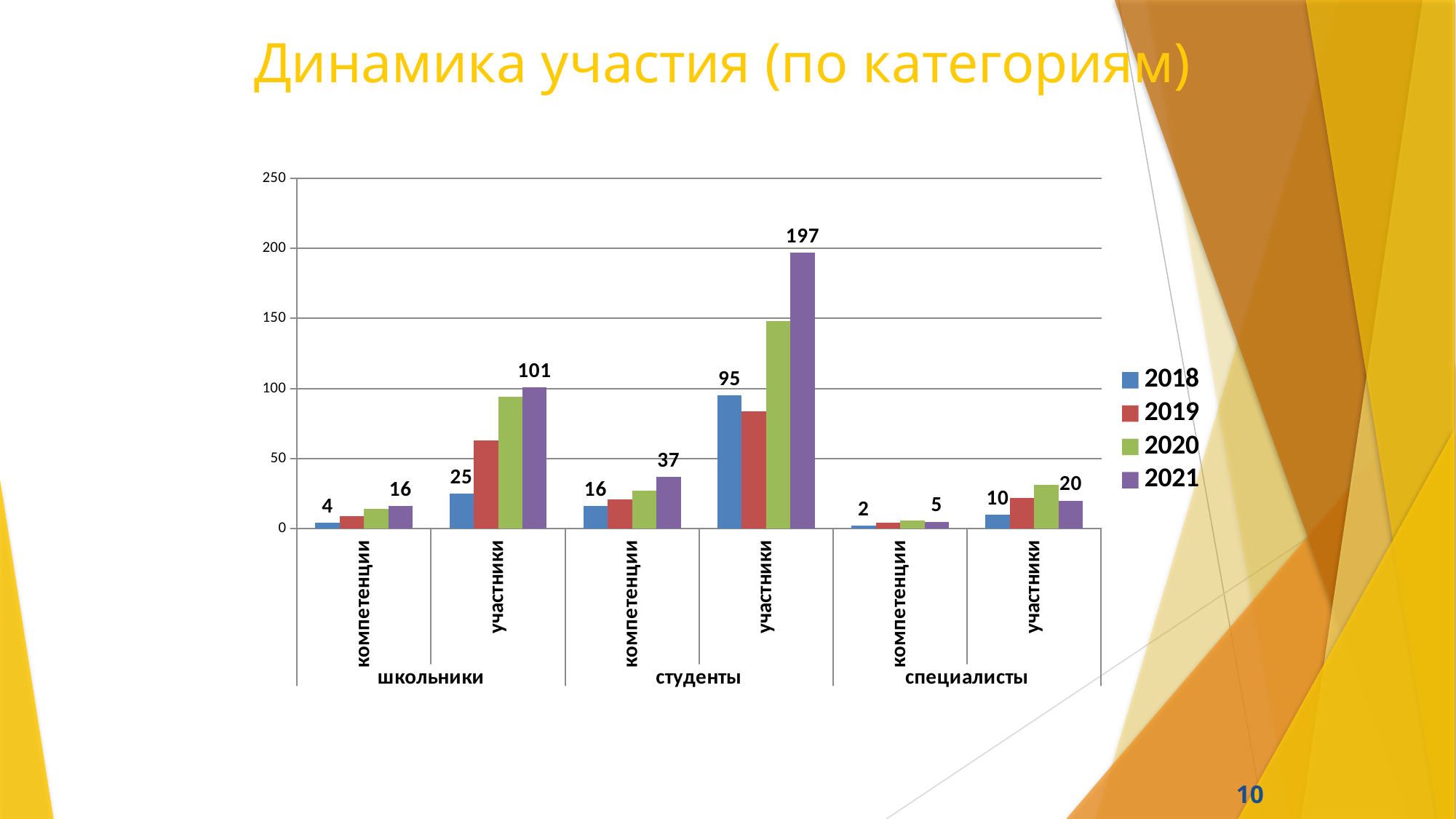
How many series does the legend list? 4 Which is larger: the 2021 value for участники in the школьники group or the 2018 value for участники in the студенты group? 2021 участники in школьники (101) What is the difference between the 2021 and 2018 values for участники in the студенты group? 102 What is the 2018 value for компетенции in the студенты group? 16 Which group and subcategory has the highest 2021 value? студенты, участники What type of chart is shown on the slide? bar chart What is the 2021 value for участники in the студенты group? 197 What is the 2021 value for компетенции in the специалисты group? 5 What is the 2018 value for участники in the школьники group? 25 What is the difference between the 2021 and 2018 values for участники in the школьники group? 76 Is the 2020 value for участники in the студенты group greater or less than 100? greater What is the title of the slide? Динамика участия (по категориям)